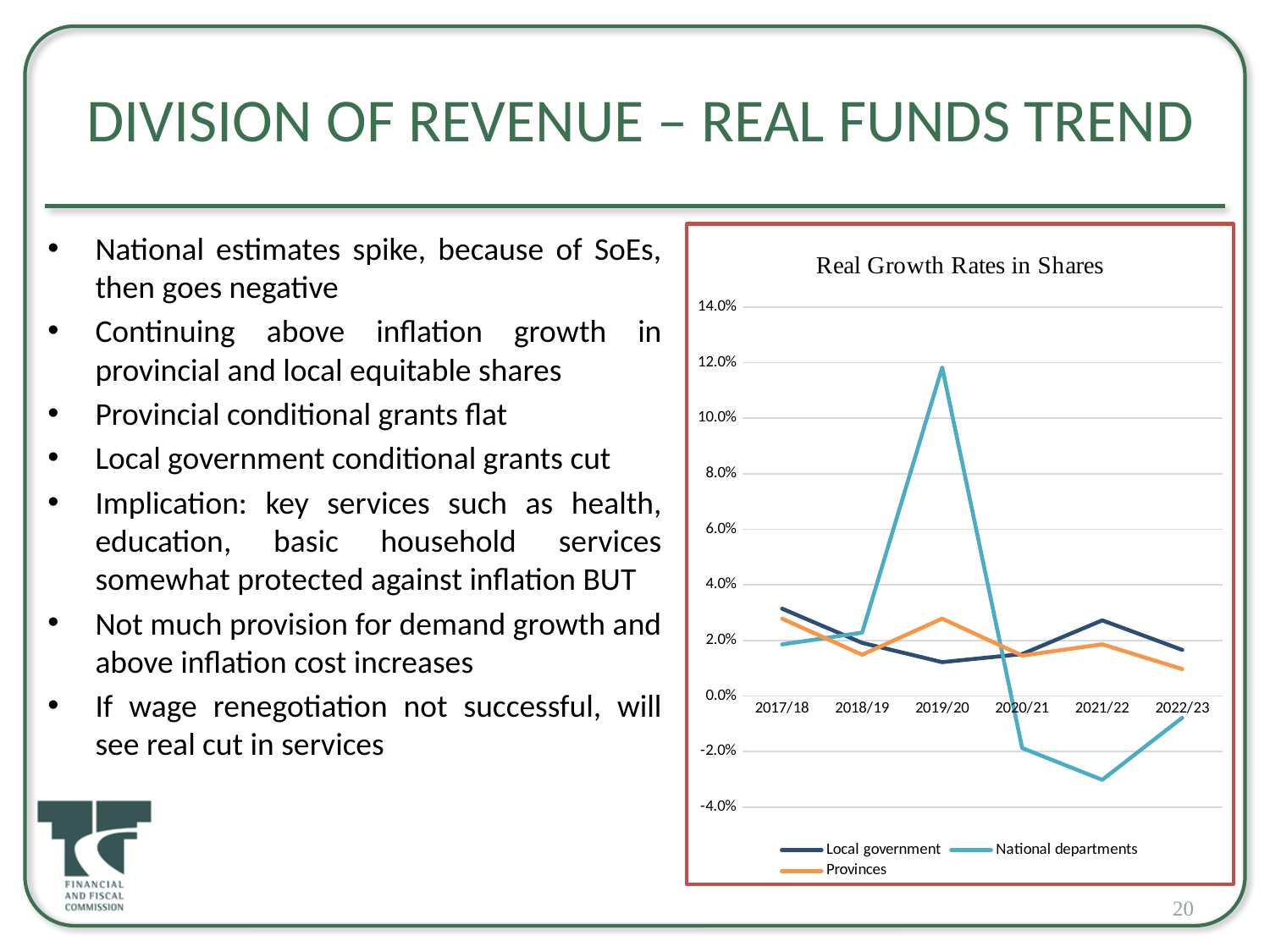
In 2021/22, which is higher: Local government or Provinces? Local government Does the National departments line rise or fall from 2019/20 to 2021/22? Fall How many years are shown on the x axis of the chart? 6 How many series does the chart's legend list? 3 What kind of chart is shown on the slide? Line chart What is the title of the chart? Real Growth Rates in Shares Which series has the highest value in 2019/20? National departments In which year does the National departments line reach its highest value? 2019/20 Is the value for Local government in 2017/18 greater or less than 2.0%? greater In which year does the National departments line reach its lowest value? 2021/22 Is the value for National departments in 2019/20 greater or less than 10.0%? greater Is the value for National departments in 2021/22 greater or less than -2.0%? less